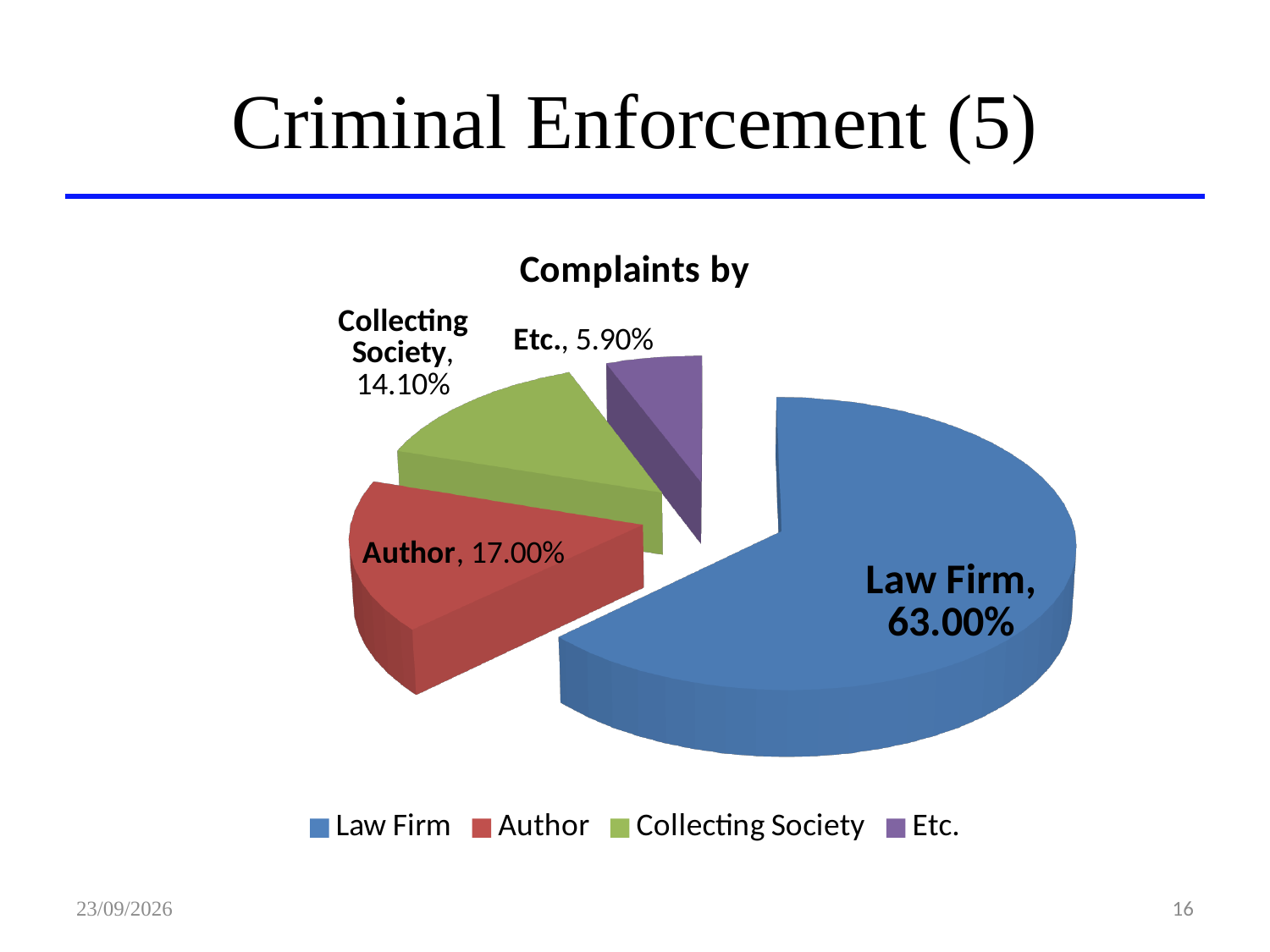
What is the title of the chart? Complaints by What is the difference in percentage points between the Author share and the Collecting Society share? 2.90% How many categories are shown in the pie chart? 4 Which category accounts for the smallest share of complaints? Etc. What is the difference in percentage points between the Law Firm share and the Author share? 46.00% What share of complaints is attributed to Law Firm? 63.00% What share of complaints is attributed to Etc.? 5.90% Which has a larger share of complaints, Collecting Society or Etc.? Collecting Society What type of chart is shown on the slide? Pie chart What share of complaints is attributed to Collecting Society? 14.10% Which category accounts for the largest share of complaints? Law Firm What share of complaints is attributed to Author? 17.00%